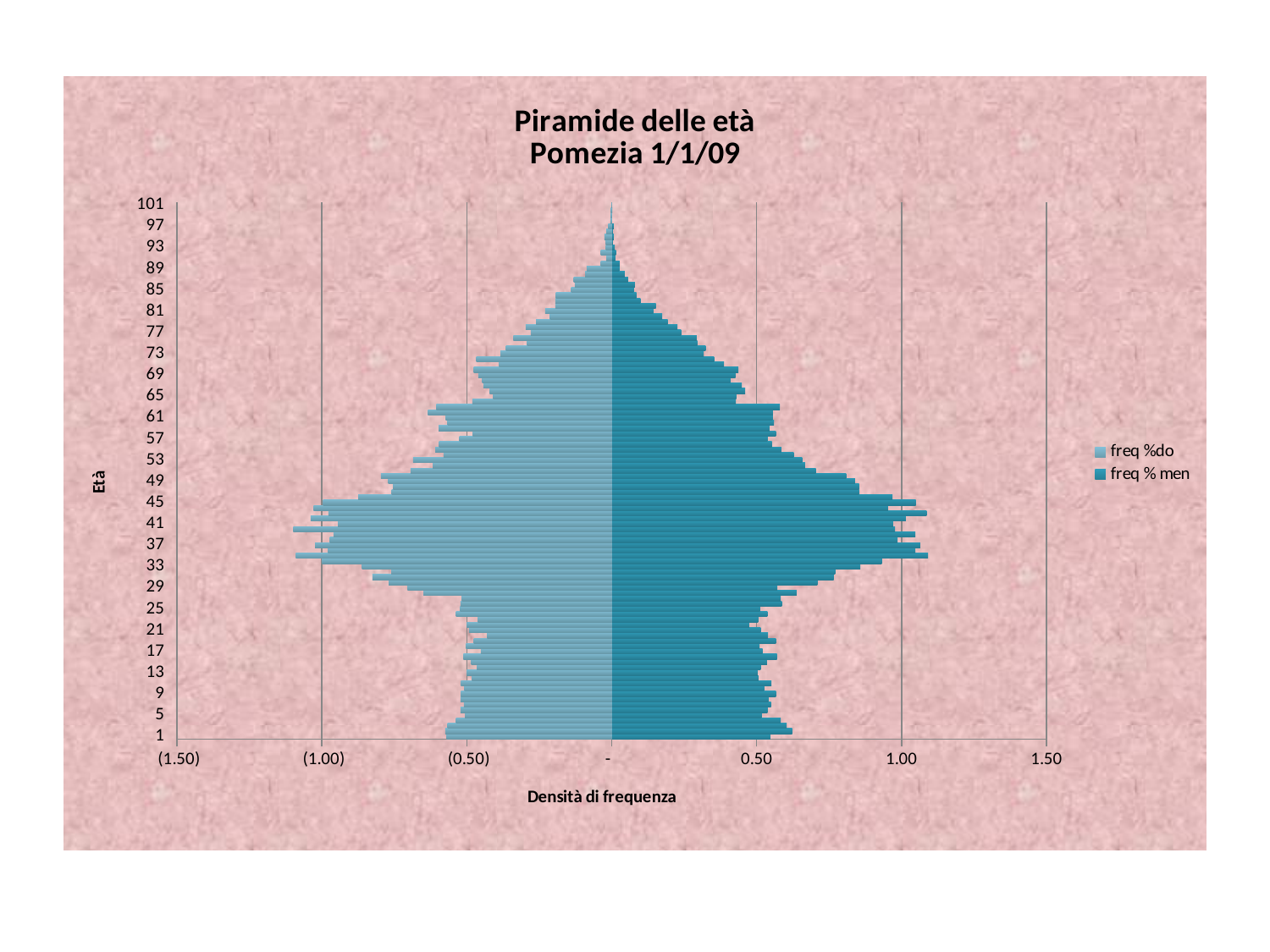
Is the freq % men value for age 45 greater or less than 0.50? greater What is the label of the horizontal axis? Densità di frequenza Is the freq % men value for age 35 greater or less than 1.00? greater Is the freq % men value for age 1 greater or less than 1.00? less Which is larger, the freq % men value for age 41 or for age 81? age 41 From age 45 up to age 101, do the freq % men values generally rise or fall as age increases? fall What is the title of the chart? Piramide delle età Pomezia 1/1/09 How many series does the legend list? 2 What kind of chart is shown on the slide? bar chart